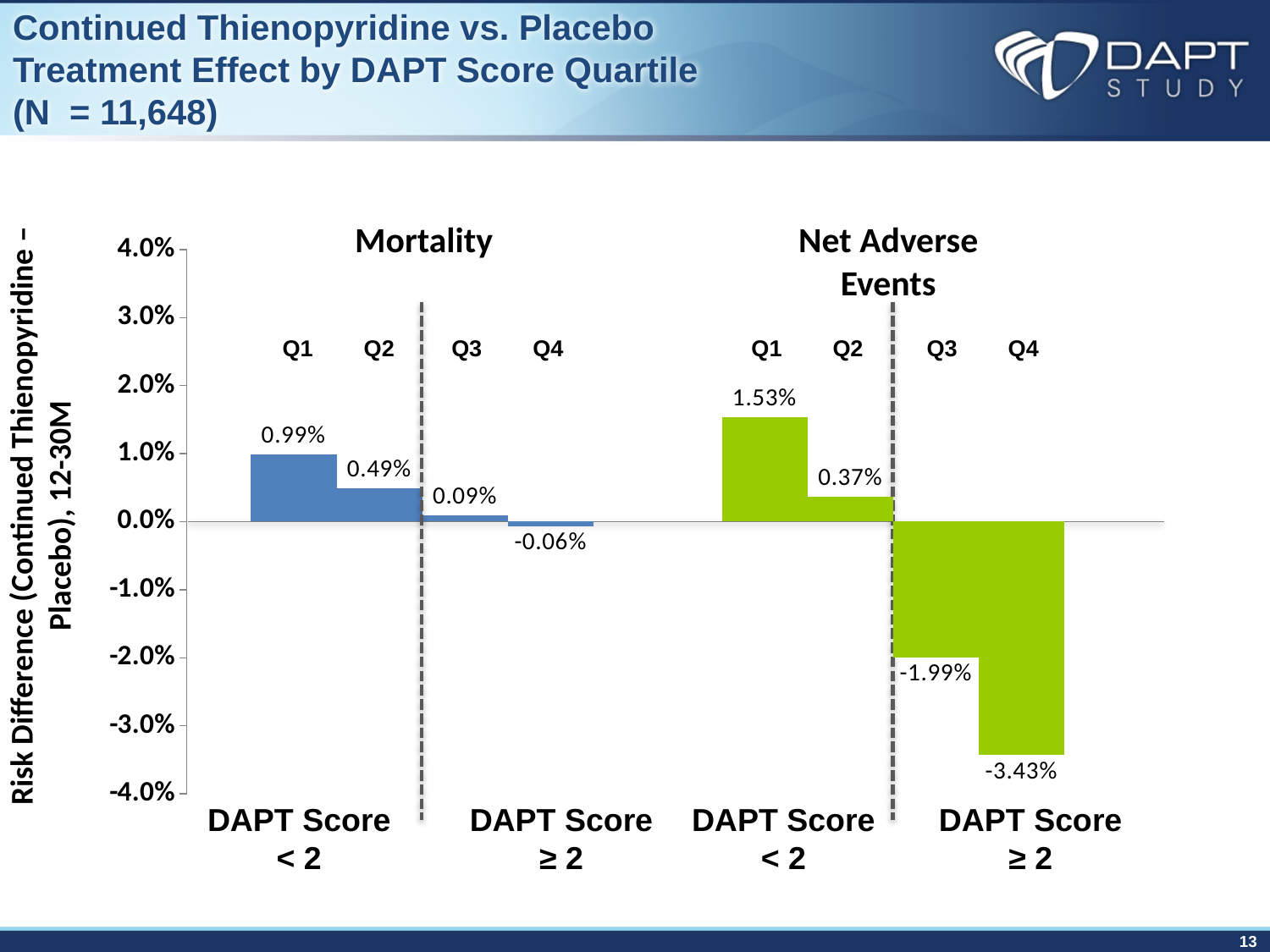
Which quartile has the lowest risk difference for Mortality? Q4 What is the difference between the Mortality risk differences for Q1 and Q2? 0.50% What kind of chart is shown on the slide? bar chart What is the risk difference for Net Adverse Events in quartile Q3? -1.99% What is the risk difference for Mortality in quartile Q1? 0.99% What colour are the Net Adverse Events bars? green Which quartile has the highest risk difference for Net Adverse Events? Q1 What is the risk difference for Mortality in quartile Q4? -0.06% Do the Net Adverse Events risk differences rise or fall from Q1 to Q4? fall Which quartile has the lowest risk difference for Net Adverse Events? Q4 What is the risk difference for Net Adverse Events in quartile Q4? -3.43% Which is larger, the Q1 risk difference for Mortality or the Q1 risk difference for Net Adverse Events? Net Adverse Events